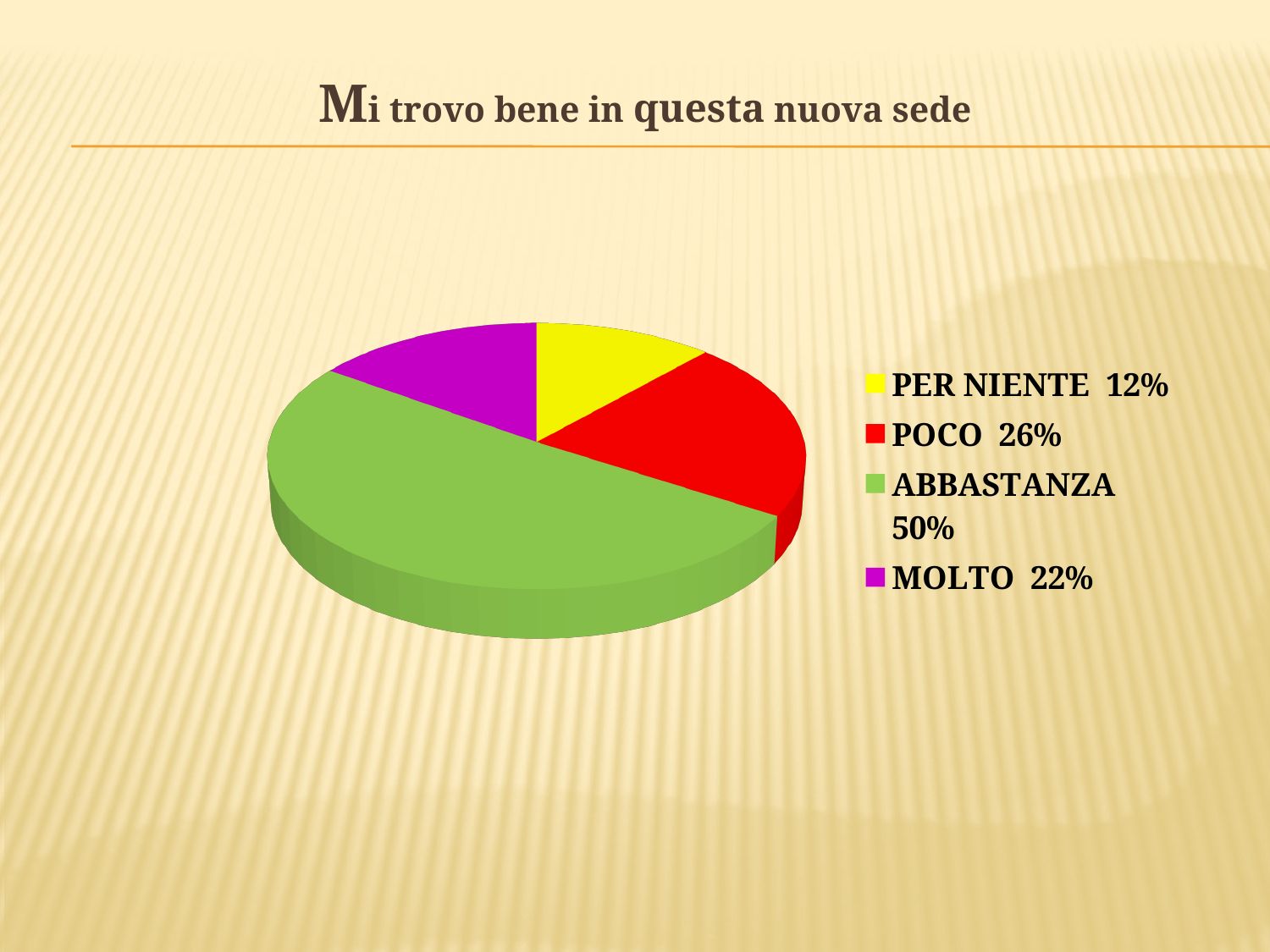
What kind of chart is shown on the slide? pie chart What percentage is shown for MOLTO? 22% What percentage is shown for ABBASTANZA? 50% Which category has the smallest share of the pie? PER NIENTE What is the title of the slide? Mi trovo bene in questa nuova sede What percentage is shown for POCO? 26% Which category has the largest share of the pie? ABBASTANZA What percentage is shown for PER NIENTE? 12% How many categories does the pie chart have? 4 Which is larger, the share for POCO or the share for MOLTO? POCO What is the difference between the shares for POCO and MOLTO? 4% What colour is the slice for MOLTO? purple